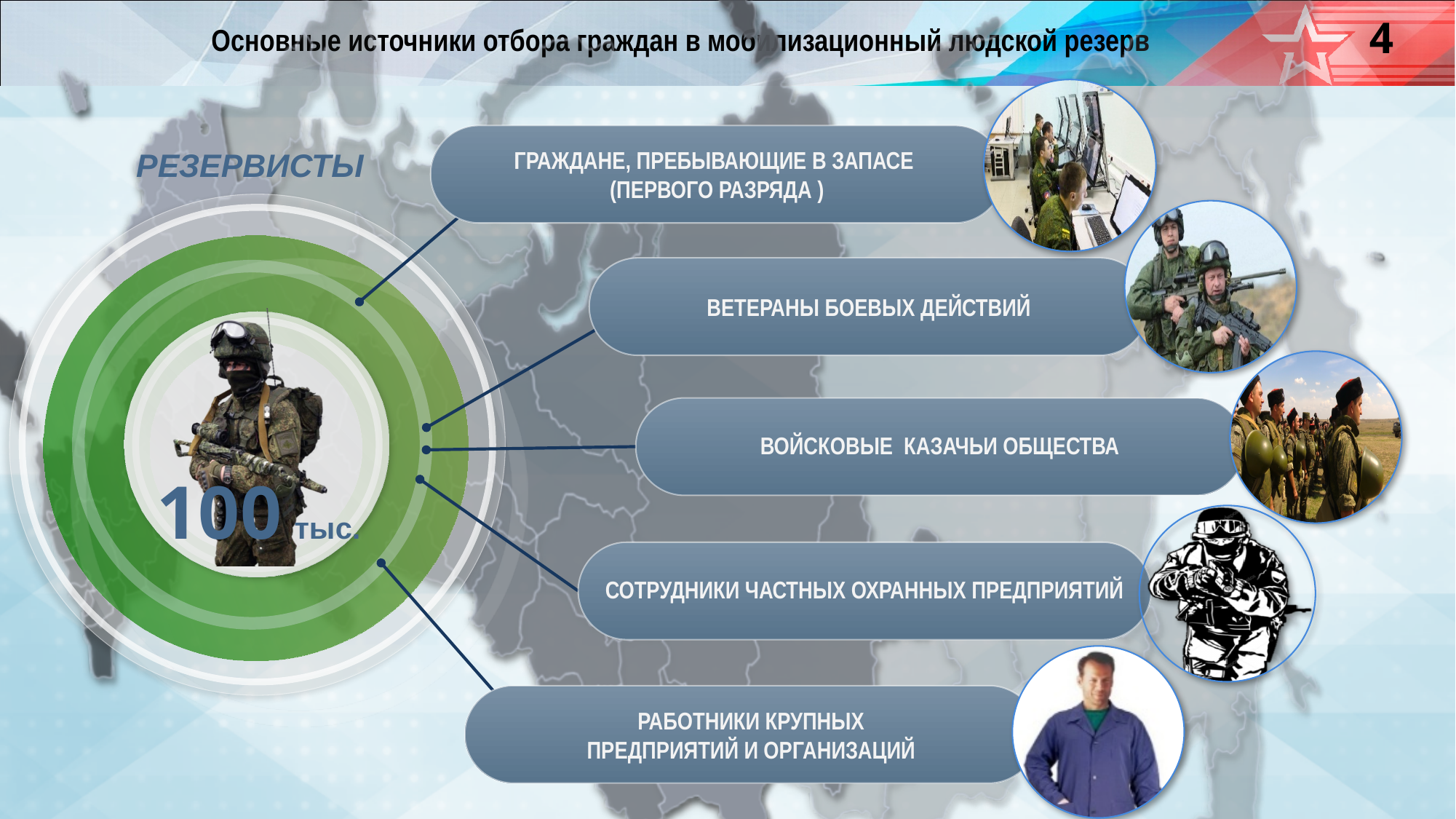
What colour are the rings of the circular graphic on the left? Green What number is shown in the centre of the ring graphic for РЕЗЕРВИСТЫ? 100 тыс. Which category is listed first (at the top) among the sources? ГРАЖДАНЕ, ПРЕБЫВАЮЩИЕ В ЗАПАСЕ (ПЕРВОГО РАЗРЯДА) What is the title of the slide? Основные источники отбора граждан в мобилизационный людской резерв Which category is listed last (at the bottom) among the sources? РАБОТНИКИ КРУПНЫХ ПРЕДПРИЯТИЙ И ОРГАНИЗАЦИЙ How many sources of selection for the mobilization reserve are listed on the slide? 5